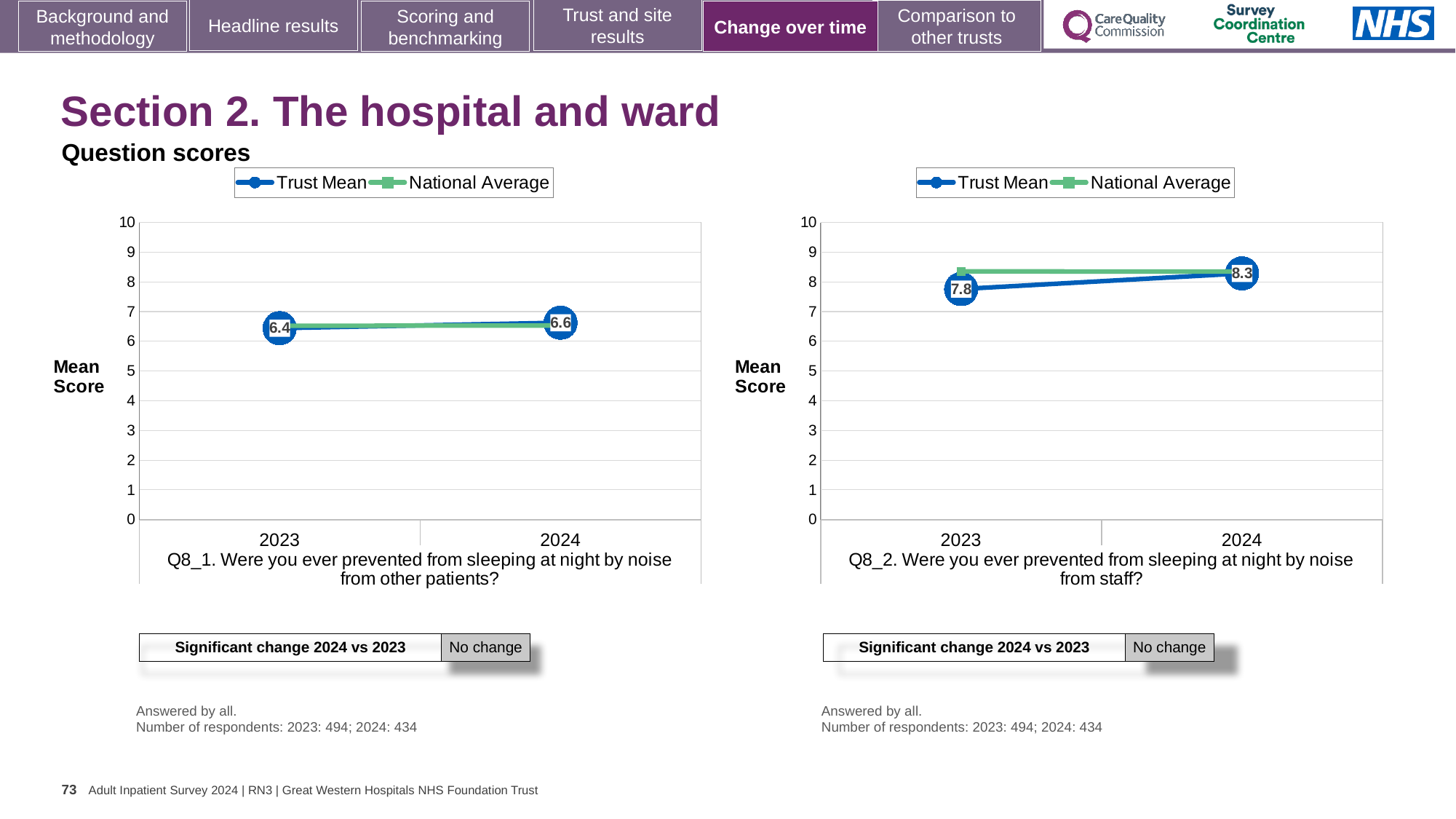
What kind of chart is the left chart (Q8_1)? line chart How many years are shown on the x axis of the left chart (Q8_1)? 2 On the right chart (Q8_2), is the National Average value for 2023 greater or less than 7? greater How many series does the legend of the right chart (Q8_2) list? 2 On the left chart (Q8_1), what is the Trust Mean score for 2024? 6.6 On the left chart (Q8_1), what is the Trust Mean score for 2023? 6.4 On the left chart (Q8_1), by how much did the Trust Mean change from 2023 to 2024? 0.2 On the right chart (Q8_2), does the Trust Mean rise or fall from 2023 to 2024? rise On the right chart (Q8_2), what is the Trust Mean score for 2023? 7.8 On the right chart (Q8_2), what is the Trust Mean score for 2024? 8.3 On the left chart (Q8_1), which series is shown in green? National Average On the right chart (Q8_2), by how much did the Trust Mean change from 2023 to 2024? 0.5